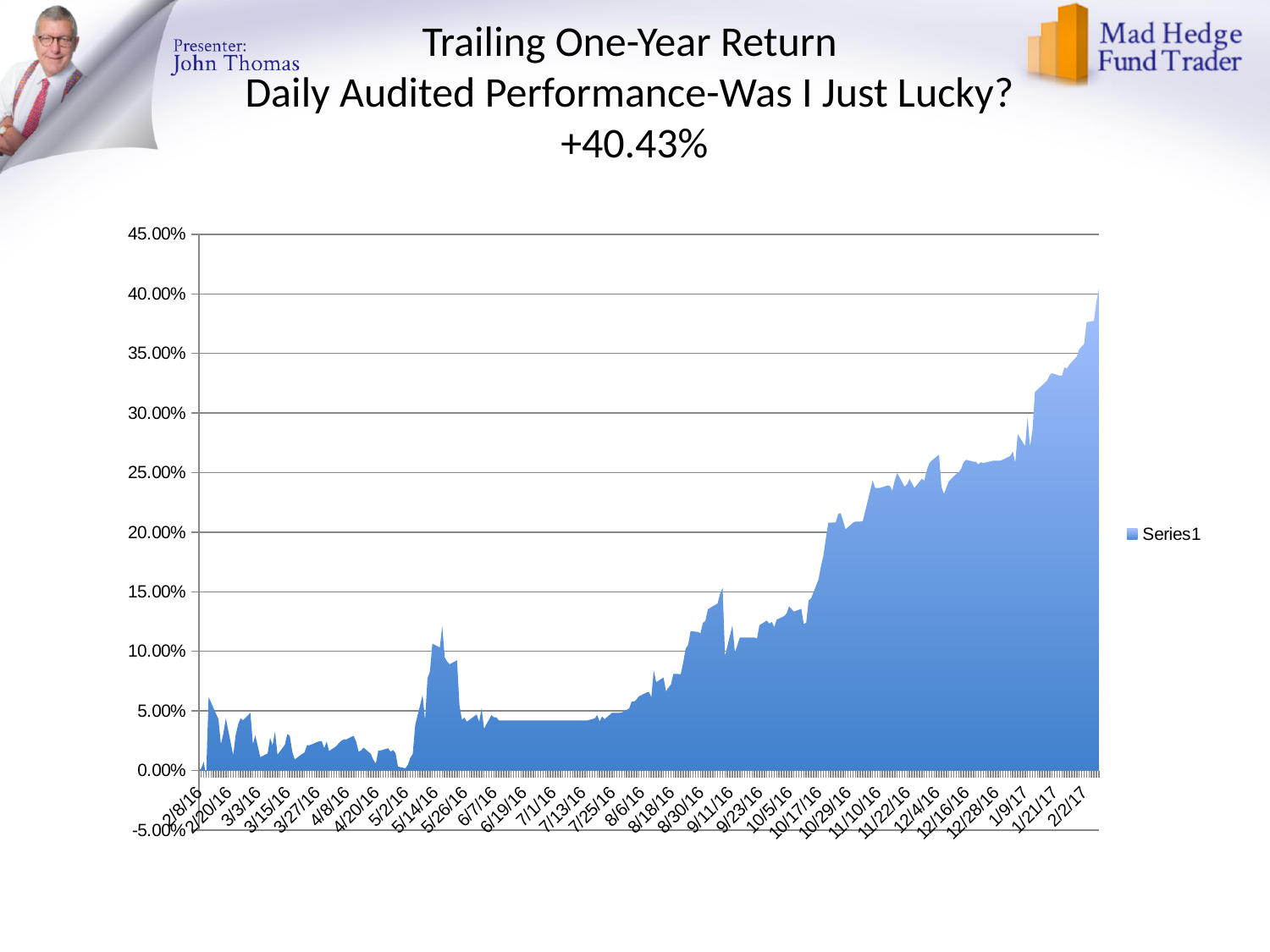
Is the value around 1/21/17 greater or less than 30.00%? greater Is the value around 5/14/16 greater or less than 5.00%? greater What kind of chart is shown on the slide? Area chart Is the value around 11/10/16 greater or less than 20.00%? greater Which is larger, the value at 2/8/16 or the value at 2/2/17? 2/2/17 What is the name of the series shown in the legend? Series1 How many series does the chart legend list? 1 Which is larger, the value around 5/14/16 or the value around 7/1/16? 5/14/16 What trailing one-year return figure is stated in the slide title? +40.43% Do the values generally rise or fall from 2/8/16 to 2/2/17? Rise